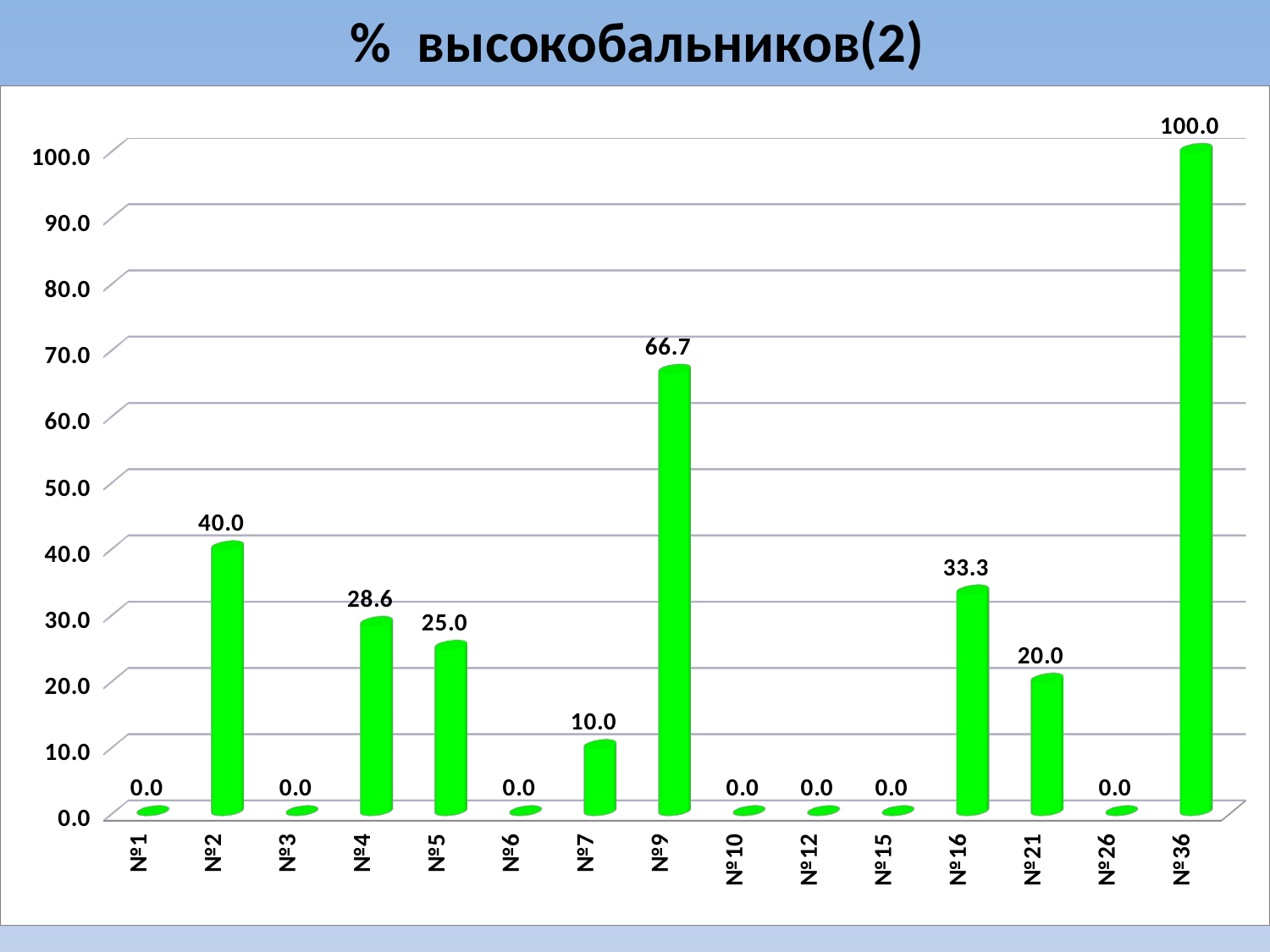
What is the difference between the values for №36 and №9? 33.3 Is the value for №9 greater or less than 60.0? greater Which is larger, the value for №2 or the value for №16? №2 How many categories are shown on the x axis? 15 What is the value for №9? 66.7 What is the value for №21? 20.0 What is the value for №4? 28.6 What kind of chart is shown on the slide? bar chart Which category has the highest value? №36 What is the title of the chart? % высокобальников(2) What is the difference between the values for №2 and №5? 15.0 What is the value for №16? 33.3